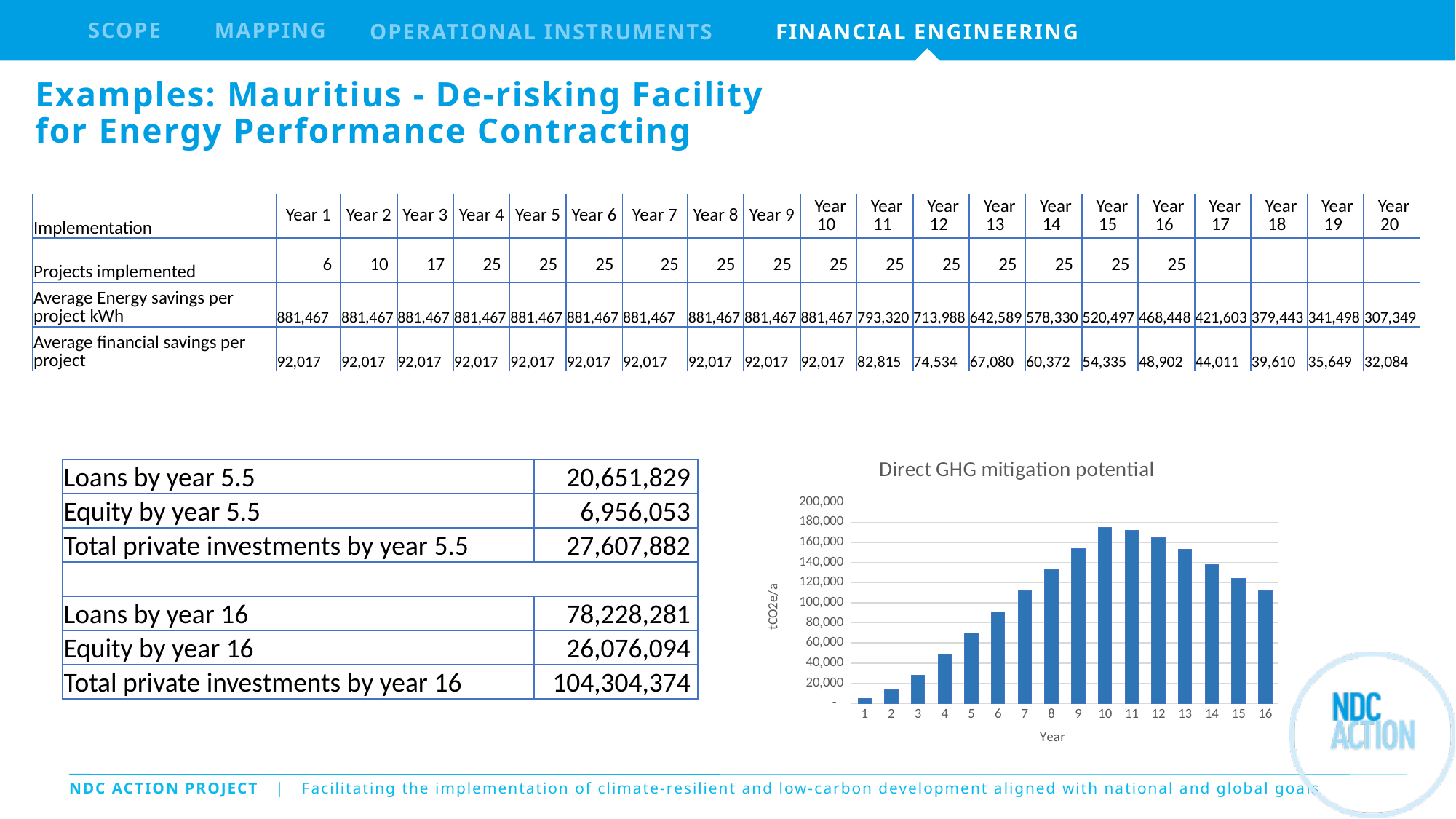
In the Direct GHG mitigation potential chart, is the value for year 3 greater or less than 40,000? less What type of chart is used to show the Direct GHG mitigation potential? bar chart In the Direct GHG mitigation potential chart, is the value for year 10 greater or less than 160,000? greater What is the label on the vertical axis of the Direct GHG mitigation potential chart? tCO2e/a In the Direct GHG mitigation potential chart, which is larger: the value for year 4 or the value for year 15? Year 15 In the Direct GHG mitigation potential chart, do the values rise or fall from year 10 to year 16? fall In the Direct GHG mitigation potential chart, is the value for year 16 greater or less than 120,000? less How many years (bars) are plotted in the Direct GHG mitigation potential chart? 16 In the Direct GHG mitigation potential chart, which year has the lowest value? Year 1 In the Direct GHG mitigation potential chart, do the values rise or fall from year 1 to year 10? rise